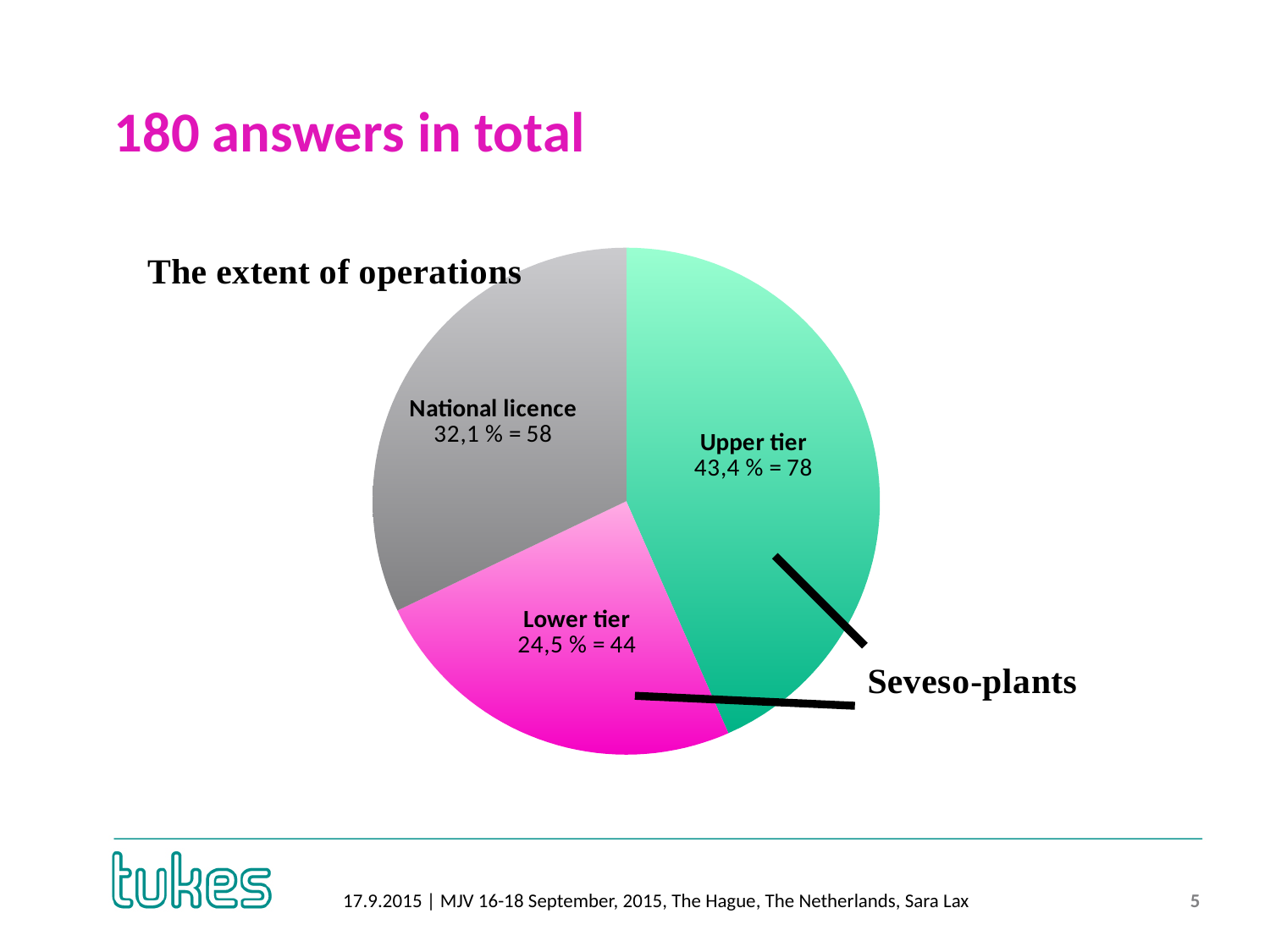
How many answers does the Lower tier slice represent? 44 What is the difference in number of answers between Upper tier and Lower tier? 34 What is the title of the chart? The extent of operations How many answers does the National licence slice represent? 58 How many slices does the pie chart have? 3 Which has more answers, National licence or Lower tier? National licence What percentage share does the Upper tier slice have? 43,4 % What kind of chart is shown on the slide? pie chart What percentage share does the Lower tier slice have? 24,5 % Which slice is the largest? Upper tier Which two slices are labelled together as Seveso-plants? Upper tier and Lower tier Which slice is the smallest? Lower tier